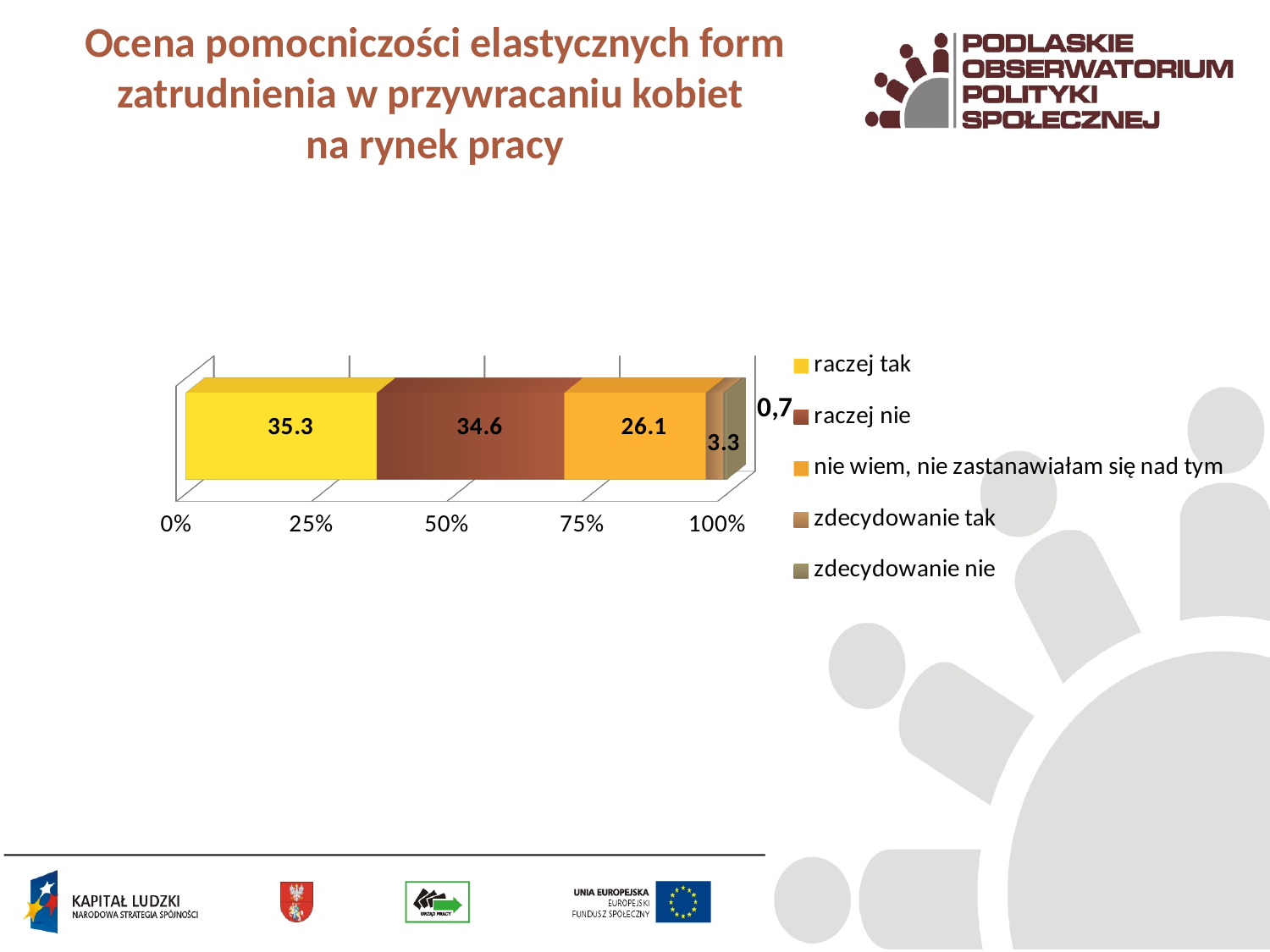
What is the title of the slide containing the chart? Ocena pomocniczości elastycznych form zatrudnienia w przywracaniu kobiet na rynek pracy What is the difference between the values for "raczej nie" and "nie wiem, nie zastanawiałam się nad tym"? 8.5 What is the value for "nie wiem, nie zastanawiałam się nad tym"? 26.1 Which response has the largest share of the bar? raczej tak What is the difference between the values for "raczej tak" and "raczej nie"? 0.7 What is the value for "raczej nie"? 34.6 How many series does the legend list? 5 What is the total of all segments in the stacked bar? 100 What kind of chart is shown on the slide? stacked bar chart Which is larger, the value for "raczej nie" or the value for "nie wiem, nie zastanawiałam się nad tym"? raczej nie Is the value for "raczej tak" greater or less than 25%? greater What is the value for "raczej tak"? 35.3